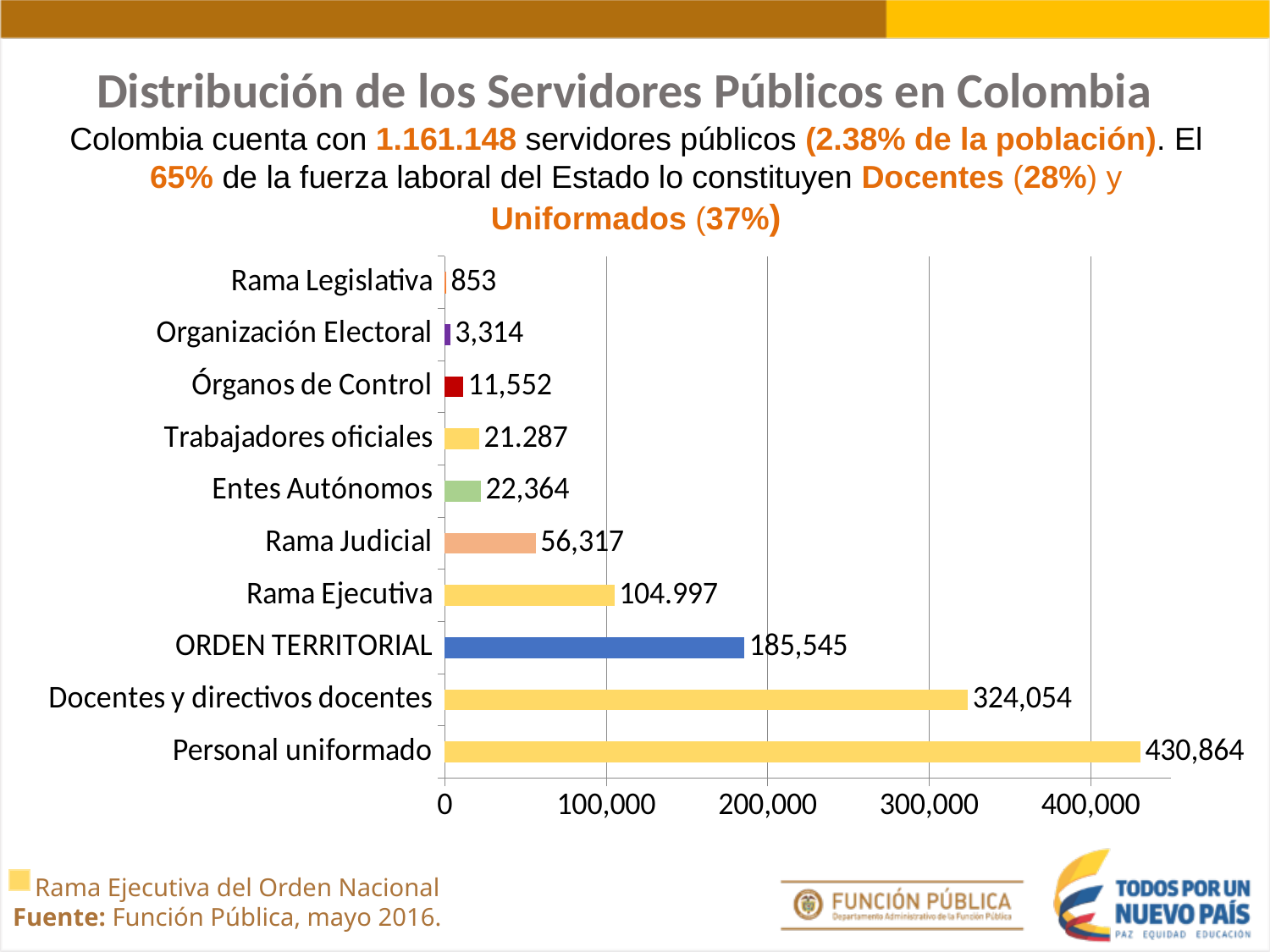
What is the difference between Personal uniformado and Docentes y directivos docentes? 106,810 Which category has the highest value? Personal uniformado What kind of chart is shown on the slide? bar chart What is the title of the slide's chart? Distribución de los Servidores Públicos en Colombia What is the value for Personal uniformado? 430,864 What is the value for Órganos de Control? 11,552 Which category has the lowest value? Rama Legislativa Which is larger, Entes Autónomos or Rama Judicial? Rama Judicial What is the value for Rama Judicial? 56,317 How many categories are shown in the chart? 10 What is the value for ORDEN TERRITORIAL? 185,545 Is the value for Docentes y directivos docentes greater or less than 400,000? less